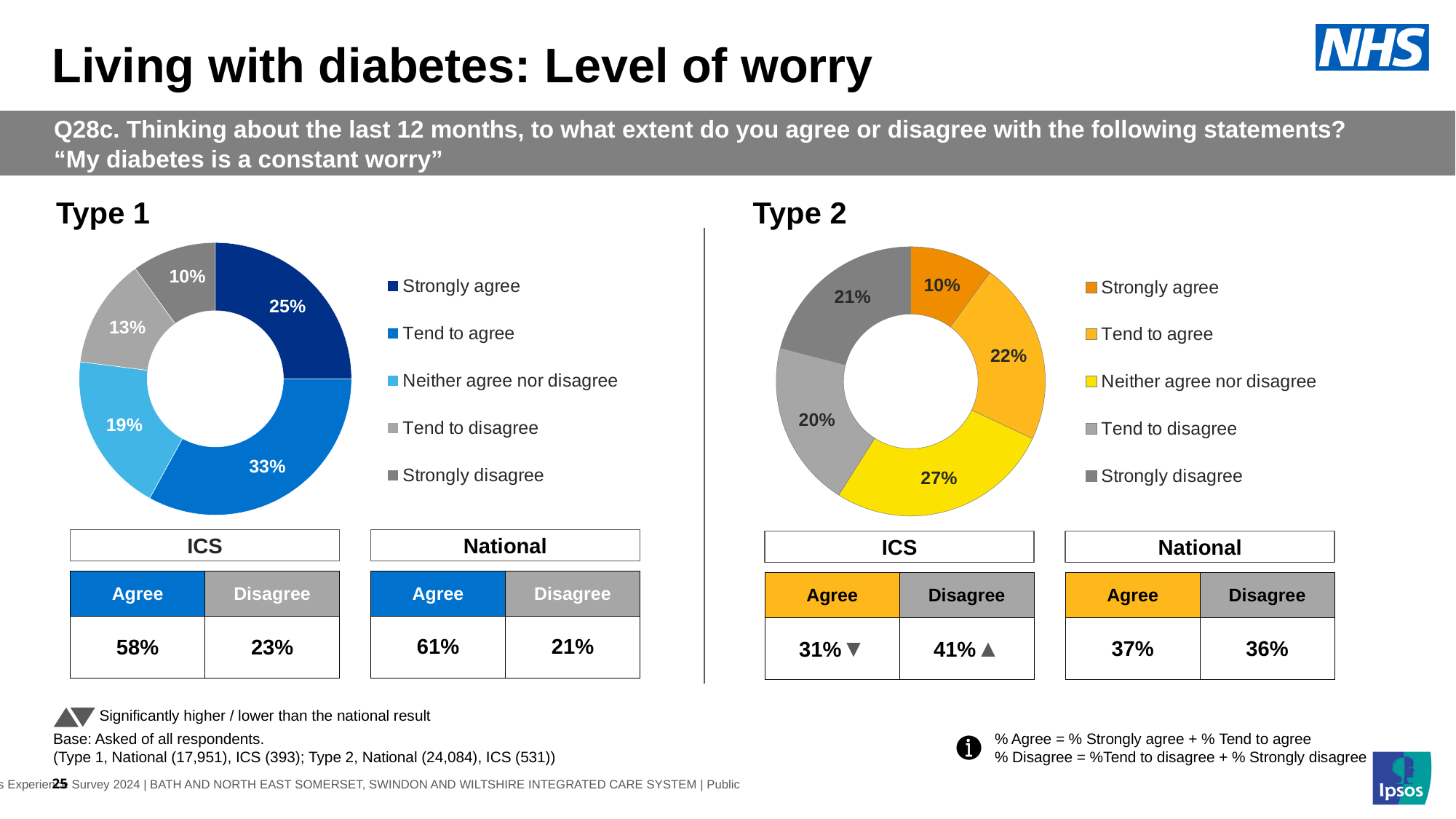
In the Type 1 chart, what percentage strongly disagree? 10% In the Type 2 chart, what percentage strongly agree? 10% In the Type 2 chart, what colour represents Neither agree nor disagree? Yellow How many response categories does the Type 2 chart's legend list? 5 In the Type 1 chart, what is the difference between the Tend to agree and Strongly agree shares? 8 percentage points In the Type 2 chart, what percentage of respondents said they neither agree nor disagree? 27% In the Type 1 chart, what percentage of respondents said they tend to agree? 33% In the Type 1 chart, which is larger: Neither agree nor disagree or Tend to disagree? Neither agree nor disagree What type of chart is used for Type 1? Donut (pie) chart In the Type 1 chart, which response category has the largest share? Tend to agree In the Type 2 chart, what is the difference between the Neither agree nor disagree and Tend to agree shares? 5 percentage points In the Type 2 chart, which response category has the smallest share? Strongly agree